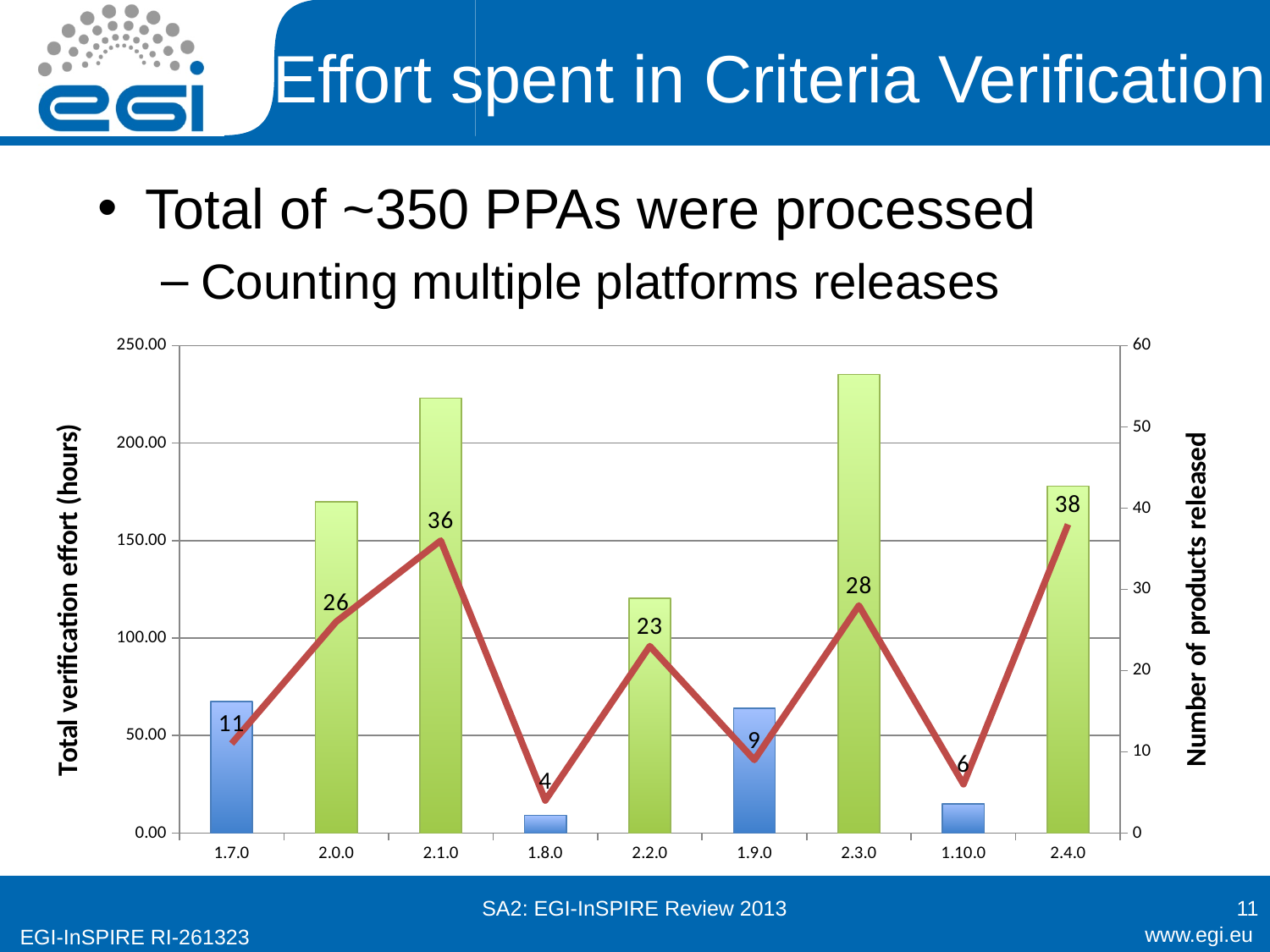
Which version has the lowest number of products released on the line series? 1.8.0 How many versions are shown on the x axis of the chart? 9 Which has more products released, version 2.0.0 or version 2.2.0? 2.0.0 What is the difference between the number of products released for 2.4.0 and for 1.8.0? 34 What is the number of products released for version 1.8.0? 4 How many products were released in version 2.1.0 according to the line series? 36 What is the title of the right-hand vertical axis? Number of products released Is the total verification effort bar for version 1.8.0 greater or less than 50.00 hours? less Which version has the highest number of products released on the line series? 2.4.0 Which version has the lowest total verification effort bar? 1.8.0 What is the number of products released for version 2.3.0? 28 Is the total verification effort bar for version 2.3.0 greater or less than 200.00 hours? greater